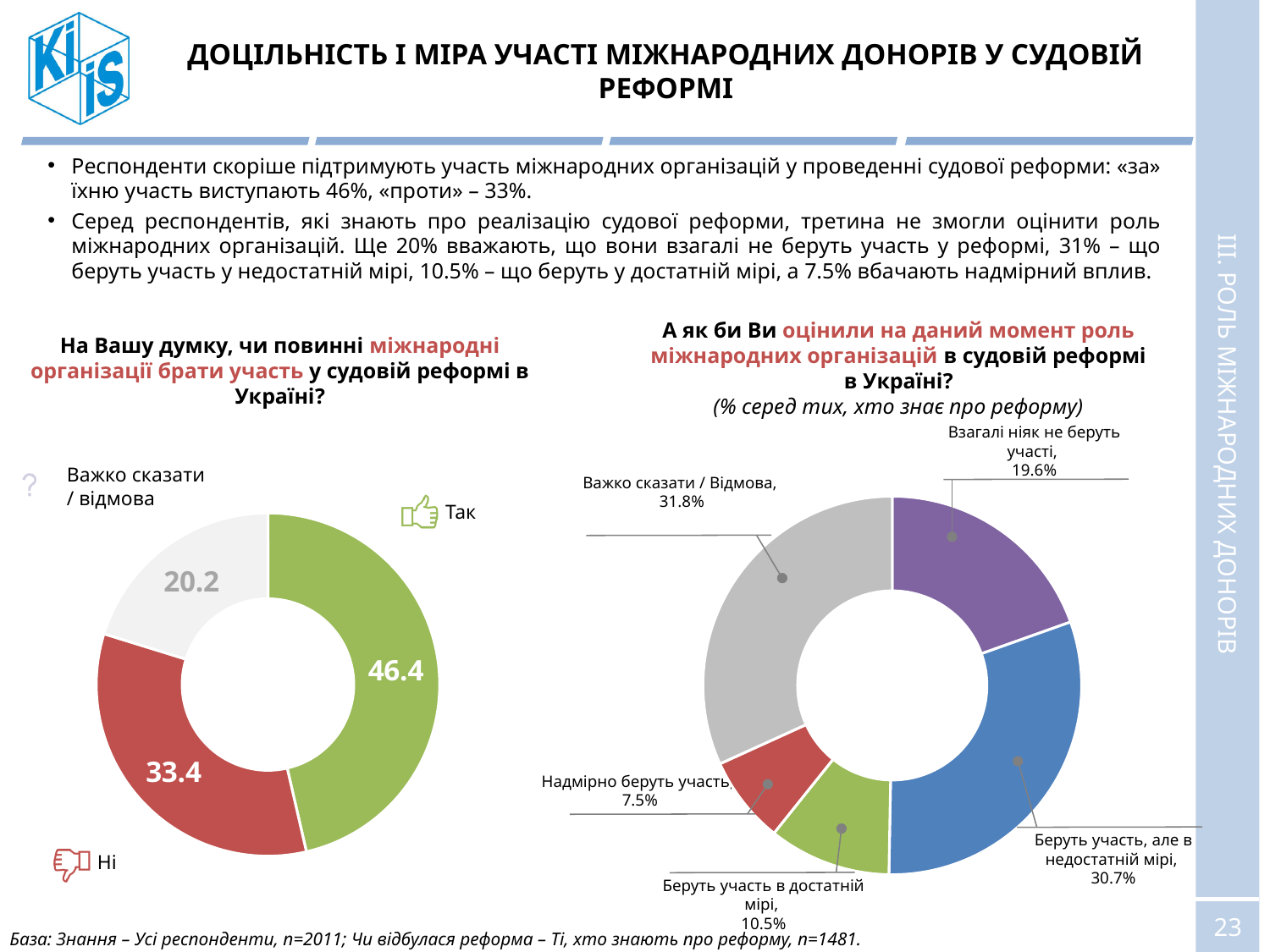
In the left chart, what is the value for "Ні"? 33.4 In the left chart, what is the value for "Так"? 46.4 How many categories does the right chart show? 5 In the left chart, which category has the largest share? Так In the right chart, what is the value for "Надмірно беруть участь"? 7.5% In the right chart, what is the value for "Беруть участь, але в недостатній мірі"? 30.7% In the left chart, what is the difference between the values for "Так" and "Ні"? 13.0 In the left chart, what is the value for "Важко сказати / відмова"? 20.2 What type of chart is the left chart? Donut (pie) chart In the right chart, which is larger: "Взагалі ніяк не беруть участі" or "Беруть участь в достатній мірі"? Взагалі ніяк не беруть участі In the right chart, what is the value for "Важко сказати / Відмова"? 31.8% In the right chart, which category has the smallest share? Надмірно беруть участь